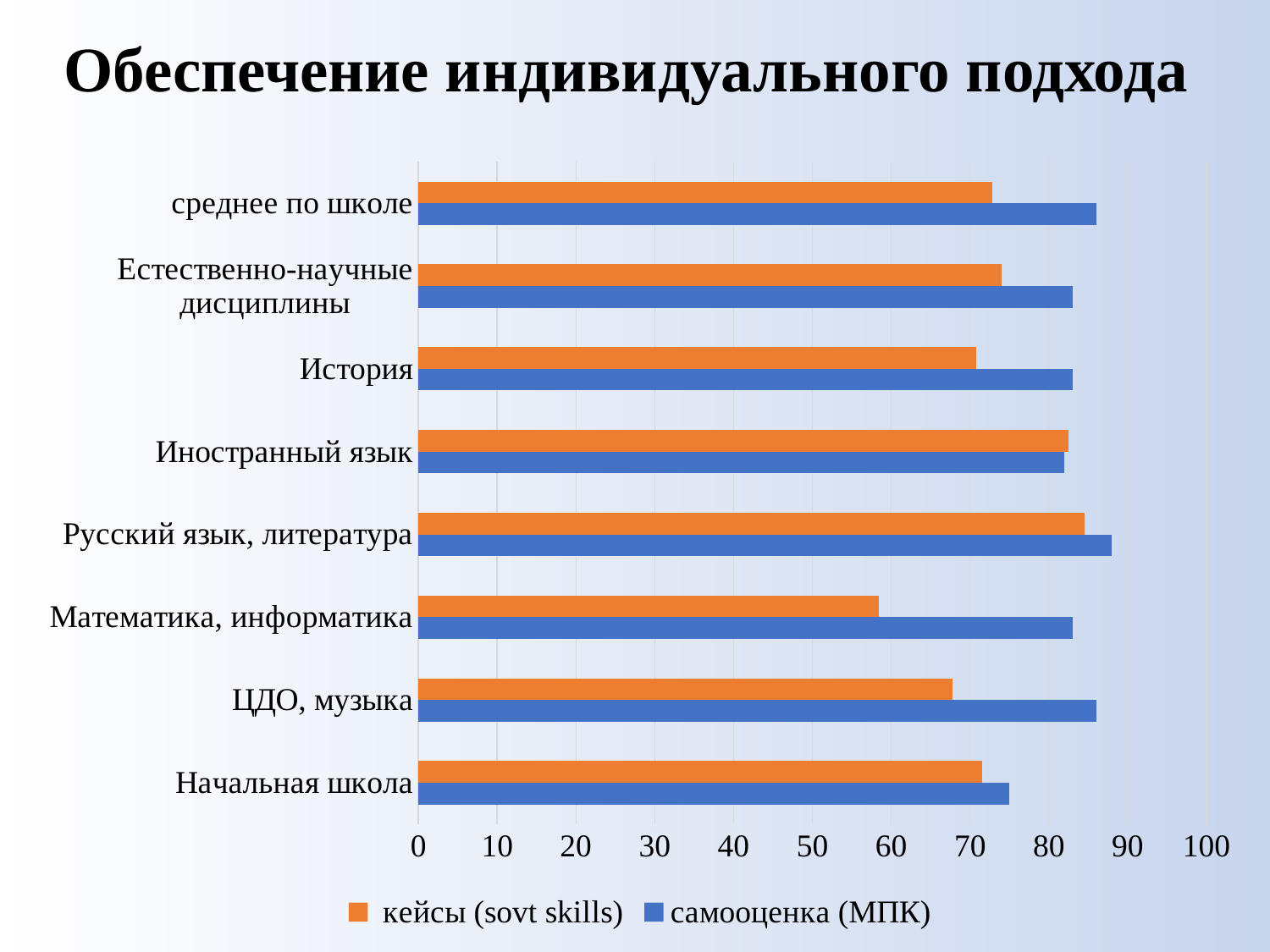
How many series does the legend list? 2 Which colour represents the series самооценка (МПК) in the legend? blue Is the value for самооценка (МПК) in Начальная школа greater or less than 80? less Is the value for самооценка (МПК) in Русский язык, литература greater or less than 80? greater For ЦДО, музыка, which series has the larger value: кейсы (sovt skills) or самооценка (МПК)? самооценка (МПК) For Математика, информатика, which series has the larger value: кейсы (sovt skills) or самооценка (МПК)? самооценка (МПК) What kind of chart is shown on the slide? bar chart Is the value for кейсы (sovt skills) in ЦДО, музыка greater or less than 70? less Which category has the lowest value for кейсы (sovt skills)? Математика, информатика Which category has the lowest value for самооценка (МПК)? Начальная школа How many categories are shown on the vertical axis? 8